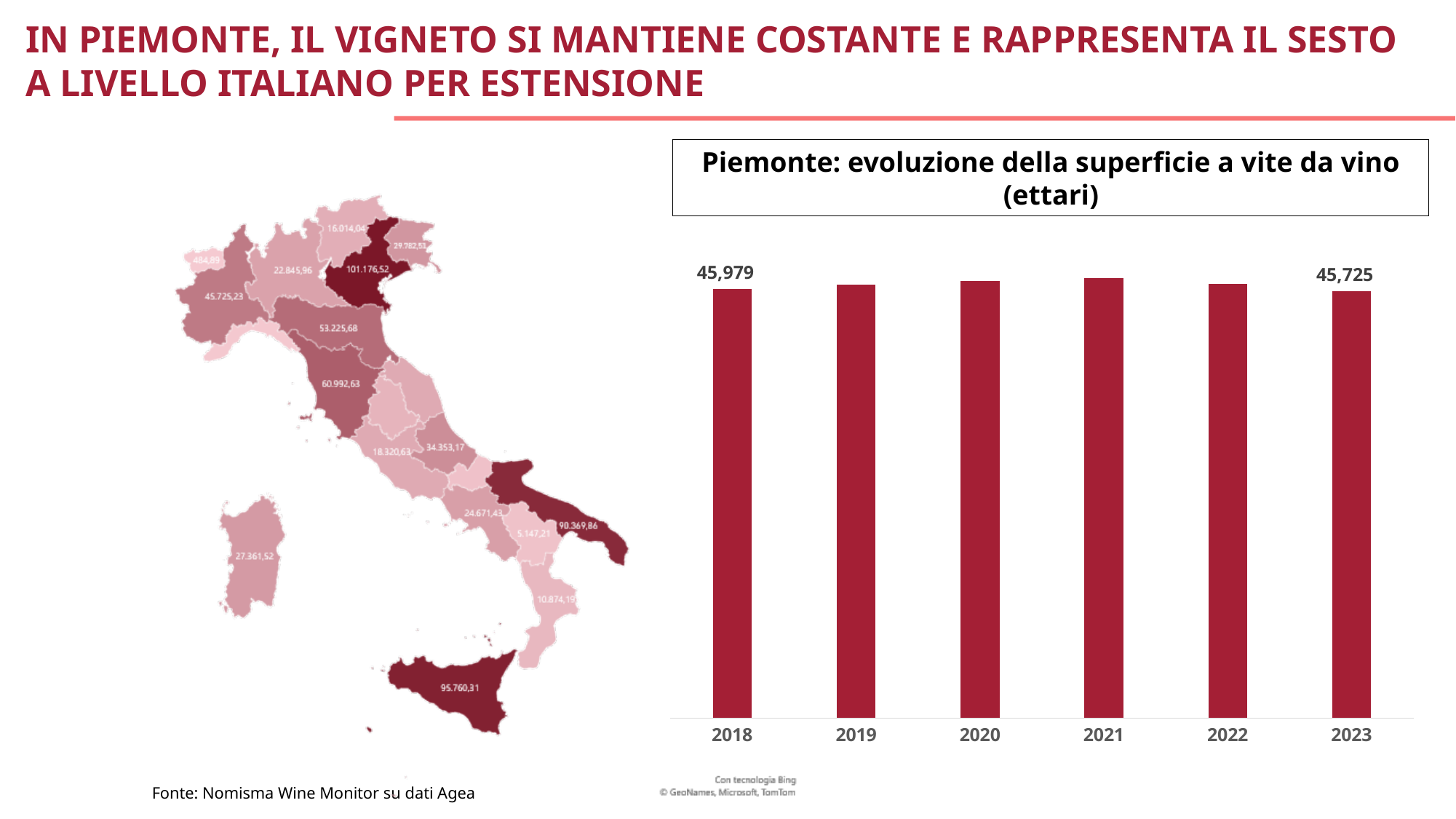
In the bar chart on the right, which is larger, the value for 2018 or the value for 2023? 2018 In the bar chart on the right, how many years are shown on the x axis? 6 In the bar chart on the right, what unit is given in the chart title? ettari In the bar chart on the right, what is the difference between the 2018 value and the 2023 value? 254 What kind of chart is the chart titled "Piemonte: evoluzione della superficie a vite da vino (ettari)"? Bar chart On the map of Italy on the left, what is the highest value printed on any region? 101.176,52 In the bar chart on the right, what is the value for 2018? 45,979 In the bar chart on the right, what is the first year shown on the x axis? 2018 On the map of Italy on the left, which is larger, the value printed on the large southern island (95.760,31) or the value printed on the heel of Italy (90.369,86)? 95.760,31 In the bar chart on the right, what is the value for 2023? 45,725 On the map of Italy on the left, what is the lowest value printed on any region? 484,89